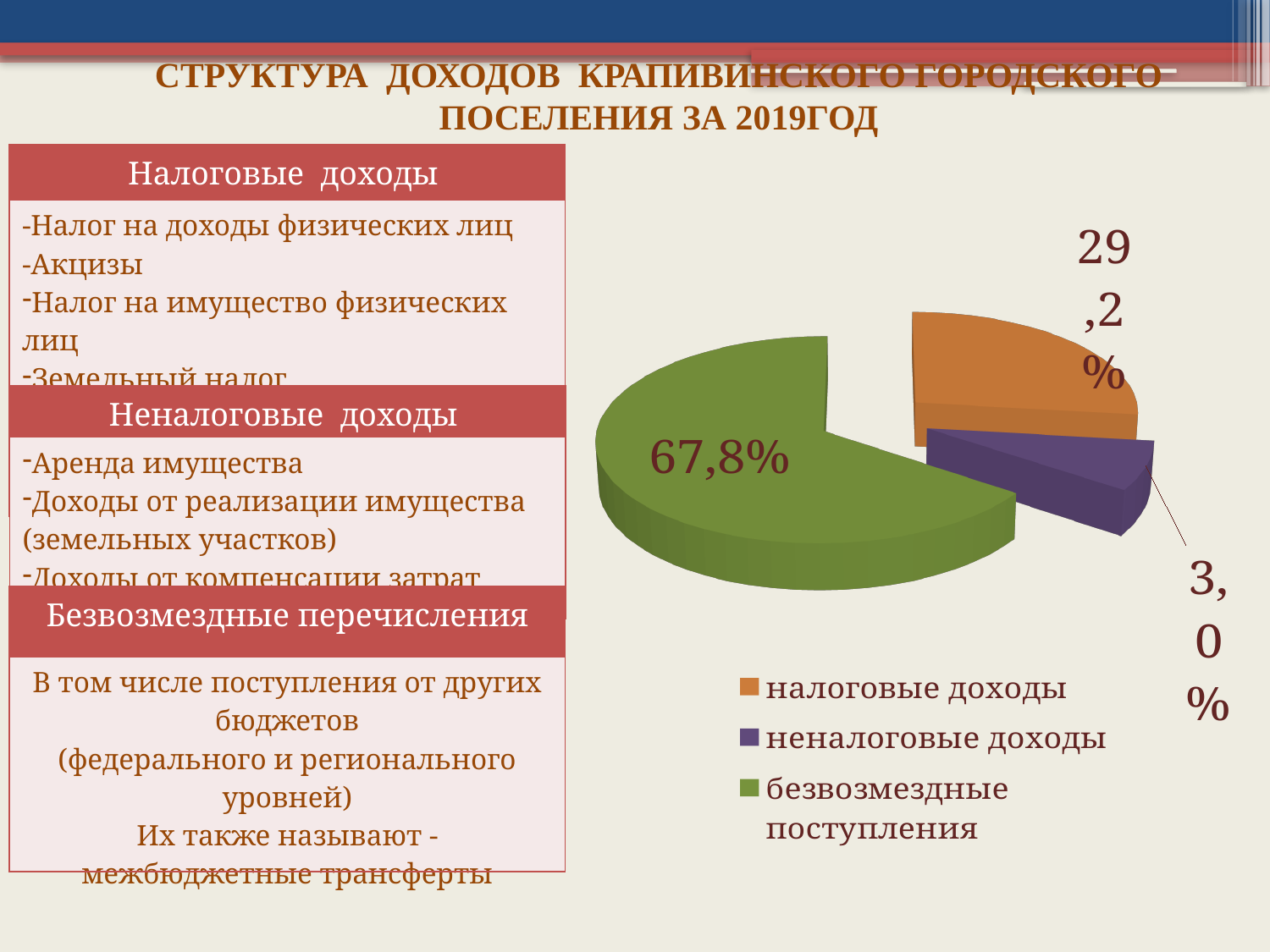
Which category has the smallest slice of the pie? неналоговые доходы Which category has the largest slice of the pie? безвозмездные поступления What colour is the slice for безвозмездные поступления? green What is the difference in percentage points between безвозмездные поступления and налоговые доходы? 38,6 What share of the pie is labelled for налоговые доходы? 29,2% Which is larger: the slice for налоговые доходы or the slice for неналоговые доходы? налоговые доходы How many slices does the pie chart have? 3 What share of the pie is labelled for безвозмездные поступления? 67,8% What colour is the slice for налоговые доходы? orange What kind of chart is shown on the slide? pie chart How many entries does the legend list? 3 What share of the pie is labelled for неналоговые доходы? 3,0%